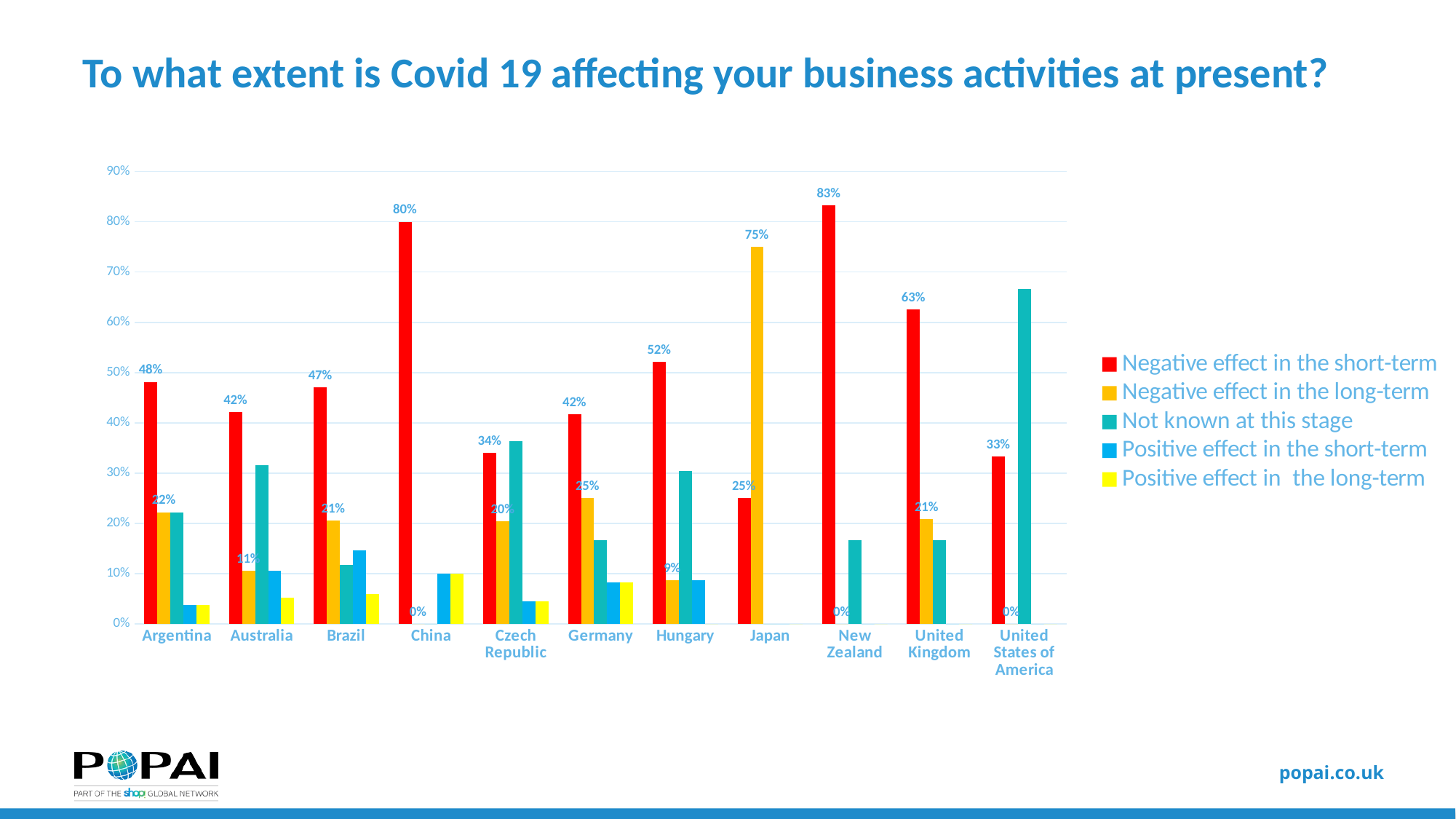
Which country has the highest value for Negative effect in the short-term? New Zealand Which is larger for Negative effect in the short-term: United Kingdom or Hungary? United Kingdom What colour represents Negative effect in the short-term in the legend? Red Is the value for Not known at this stage for United States of America greater or less than 60%? greater What is the value for Negative effect in the short-term for China? 80% What is the value for Negative effect in the long-term for Australia? 11% Which country has the lowest value for Negative effect in the short-term? Japan What is the value for Negative effect in the long-term for Japan? 75% What kind of chart is shown on the slide? Bar chart What is the difference between New Zealand and China for Negative effect in the short-term? 3 percentage points How many countries are shown on the x axis? 11 How many series does the legend list? 5